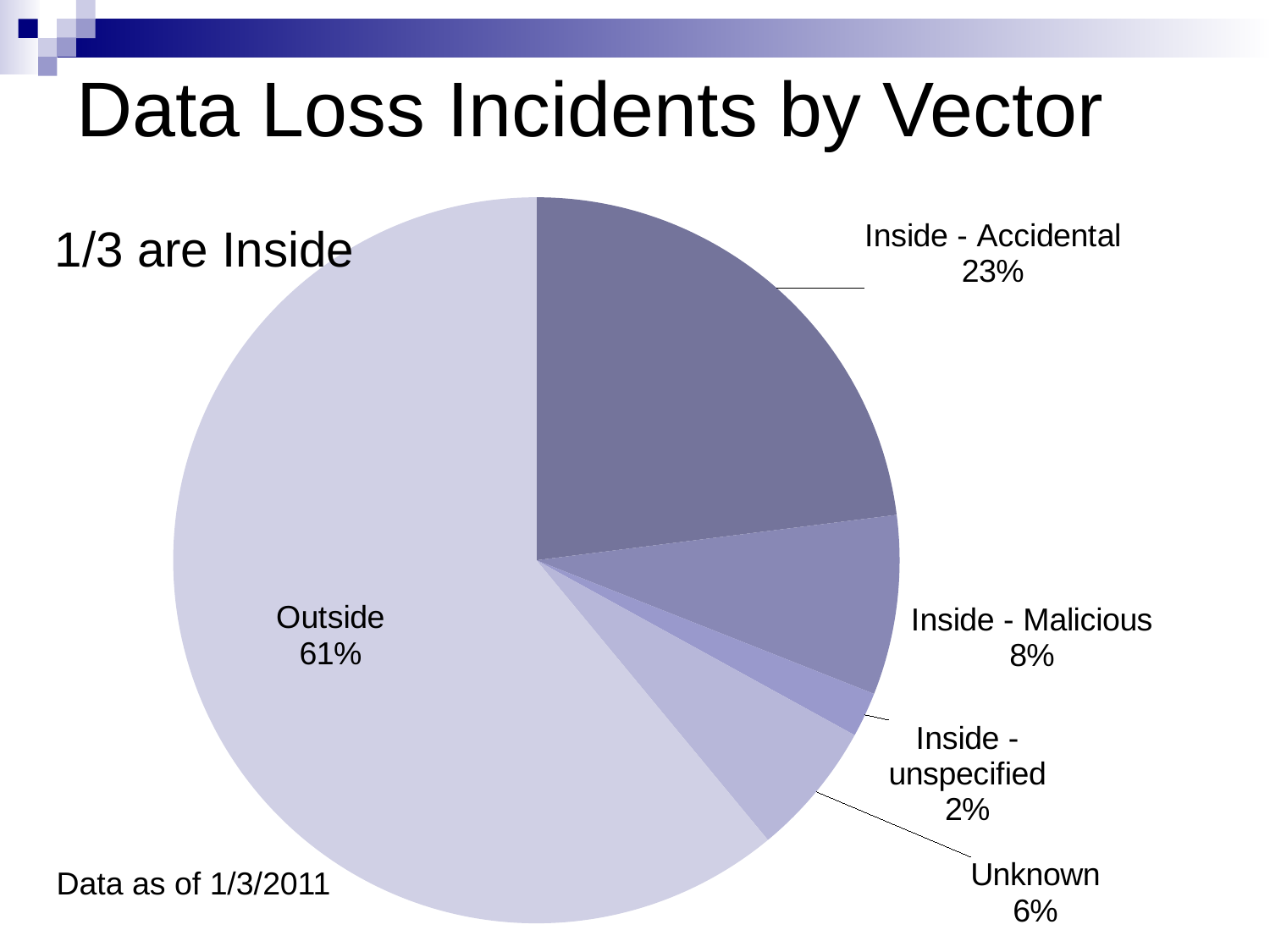
What share of data loss incidents is Inside - Malicious? 8% What is the title of the chart on the slide? Data Loss Incidents by Vector What share of data loss incidents is Inside - unspecified? 2% What kind of chart is shown on the slide? pie chart How many slices does the pie chart have? 5 What share of data loss incidents is Outside? 61% What is the difference in percentage points between Outside and Inside - Accidental? 38 What share of data loss incidents is Inside - Accidental? 23% Which is larger, Inside - Malicious or Unknown? Inside - Malicious Which slice of the pie is the smallest? Inside - unspecified What share of data loss incidents is Unknown? 6% Which slice of the pie is the largest? Outside